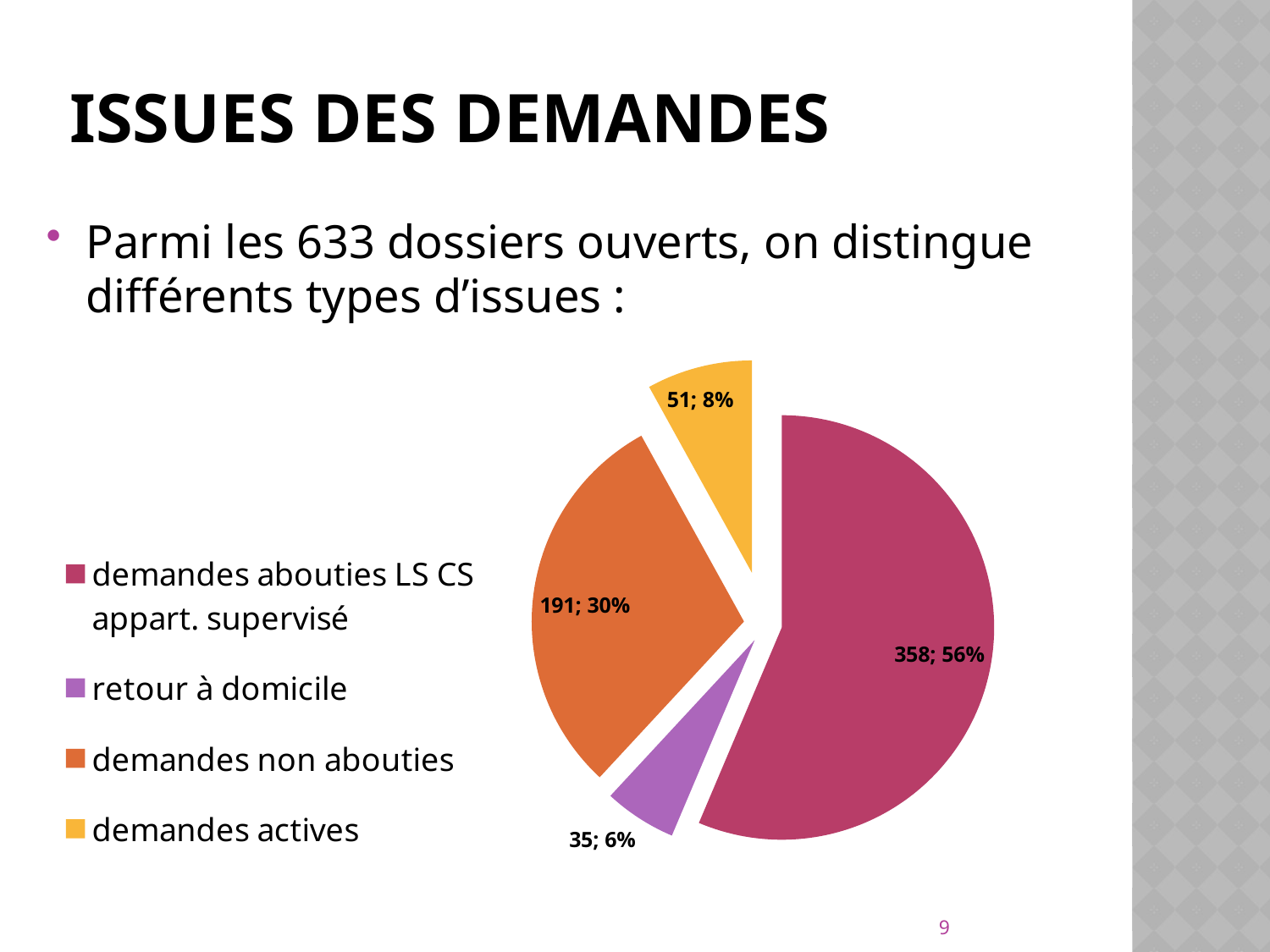
How many slices does the pie chart have? 4 What is the difference between the values for 'demandes abouties LS CS appart. supervisé' and 'demandes non abouties'? 167 Which category has the smallest slice? retour à domicile What share of the pie does 'demandes actives' represent? 8% Which is larger: 'demandes actives' or 'retour à domicile'? demandes actives What is the value for 'demandes actives'? 51 What type of chart is shown on the slide? pie chart What share of the pie does 'demandes non abouties' represent? 30% What is the value for 'demandes abouties LS CS appart. supervisé'? 358 What is the value for 'demandes non abouties'? 191 What is the value for 'retour à domicile'? 35 Which category has the largest slice? demandes abouties LS CS appart. supervisé